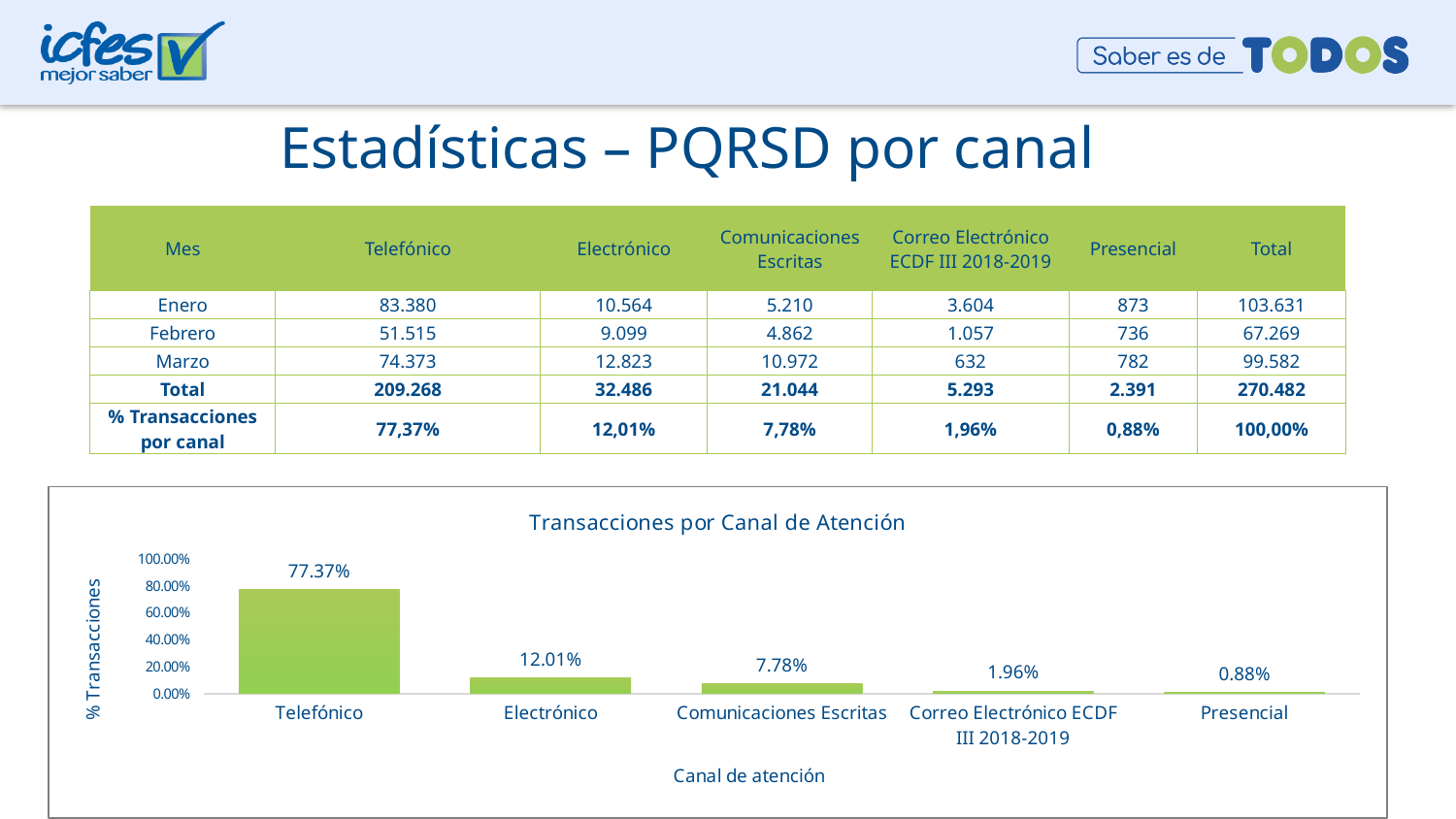
How many categories are plotted on the x axis of the chart? 5 What is the value shown for Presencial in the chart? 0.88% Which category has the highest value in the chart? Telefónico What is the difference between the values for Telefónico and Electrónico in the chart? 65.36% What type of chart is shown on the slide? bar chart What is the value shown for Telefónico in the chart? 77.37% What is the value shown for Comunicaciones Escritas in the chart? 7.78% Do the values rise or fall from left to right along the x axis of the chart? fall Which category has the lowest value in the chart? Presencial Which is larger in the chart, the value for Comunicaciones Escritas or the value for Correo Electrónico ECDF III 2018-2019? Comunicaciones Escritas What is the title of the chart? Transacciones por Canal de Atención What is the value shown for Electrónico in the chart? 12.01%